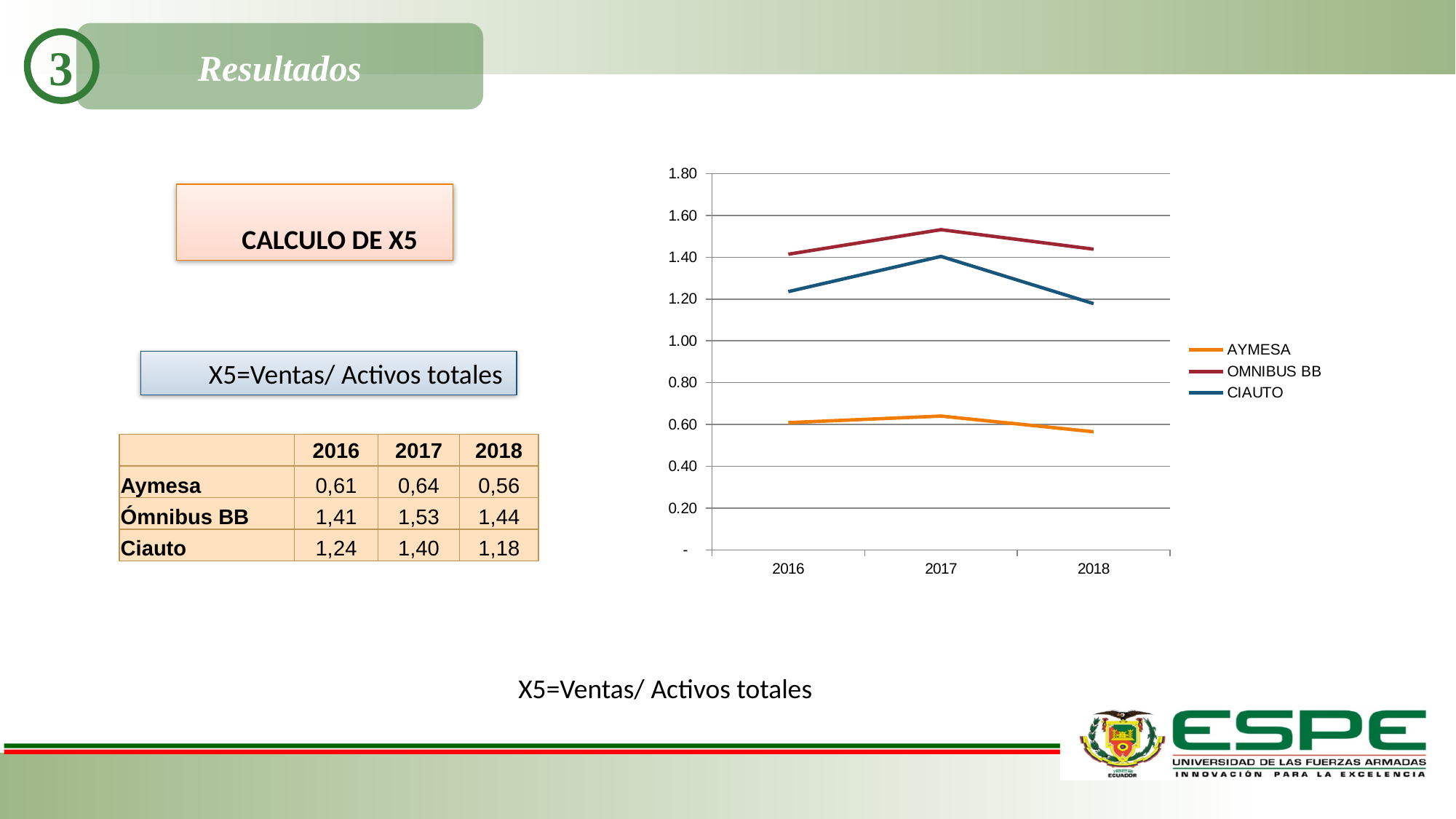
What kind of chart is shown on the slide? Line chart What is the X5 value for AYMESA in 2016? 0,61 How many series does the chart legend list? 3 What is the X5 value for CIAUTO in 2018? 1,18 What is the X5 value for OMNIBUS BB in 2017? 1,53 What is the difference between the OMNIBUS BB and CIAUTO values in 2016? 0,17 How many years are plotted along the x axis of the chart? 3 Is the value for OMNIBUS BB in 2018 greater or less than 1.20? greater Which is larger, the CIAUTO value in 2017 or the CIAUTO value in 2016? 2017 Does the AYMESA line rise or fall from 2017 to 2018? Fall Which series has the lowest value in 2018? AYMESA Which series has the highest value in 2017? OMNIBUS BB